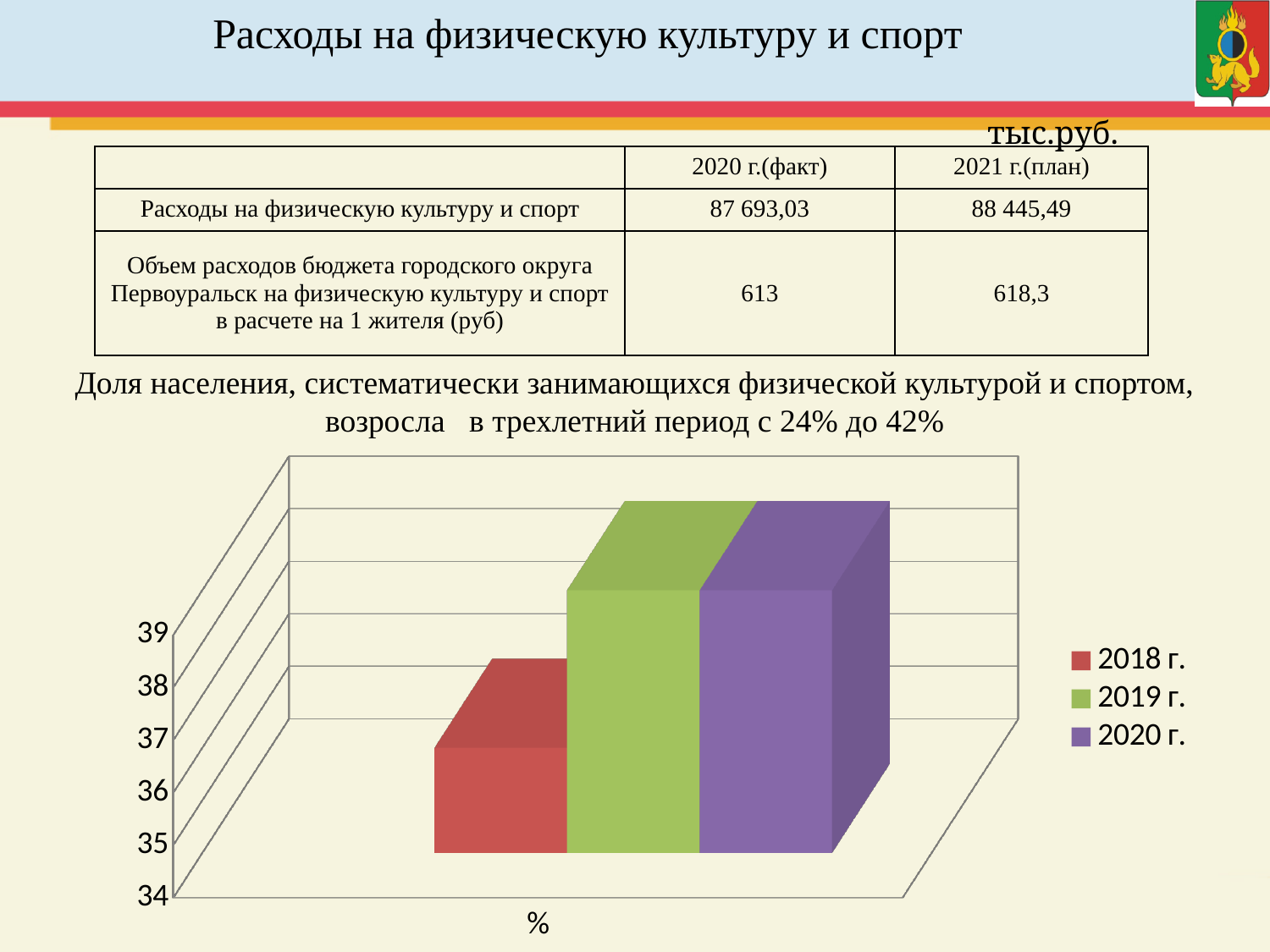
How many bars are plotted in the chart? 3 Which is larger in the chart, the bar for 2019 г. or the bar for 2018 г.? 2019 г. How many series does the chart legend list? 3 Is the value for 2020 г. greater or less than 37? greater Which year has the lowest bar in the chart? 2018 г. Is the value for 2018 г. greater or less than 38? less What kind of chart is shown on the slide? bar chart Which is larger in the chart, the bar for 2020 г. or the bar for 2018 г.? 2020 г. What label is shown under the chart's horizontal axis? % Do the bar values rise or fall from 2018 г. to 2020 г.? rise What are the lowest and highest tick values on the chart's vertical axis? 34 and 39 Is the value for 2019 г. greater or less than 37? greater